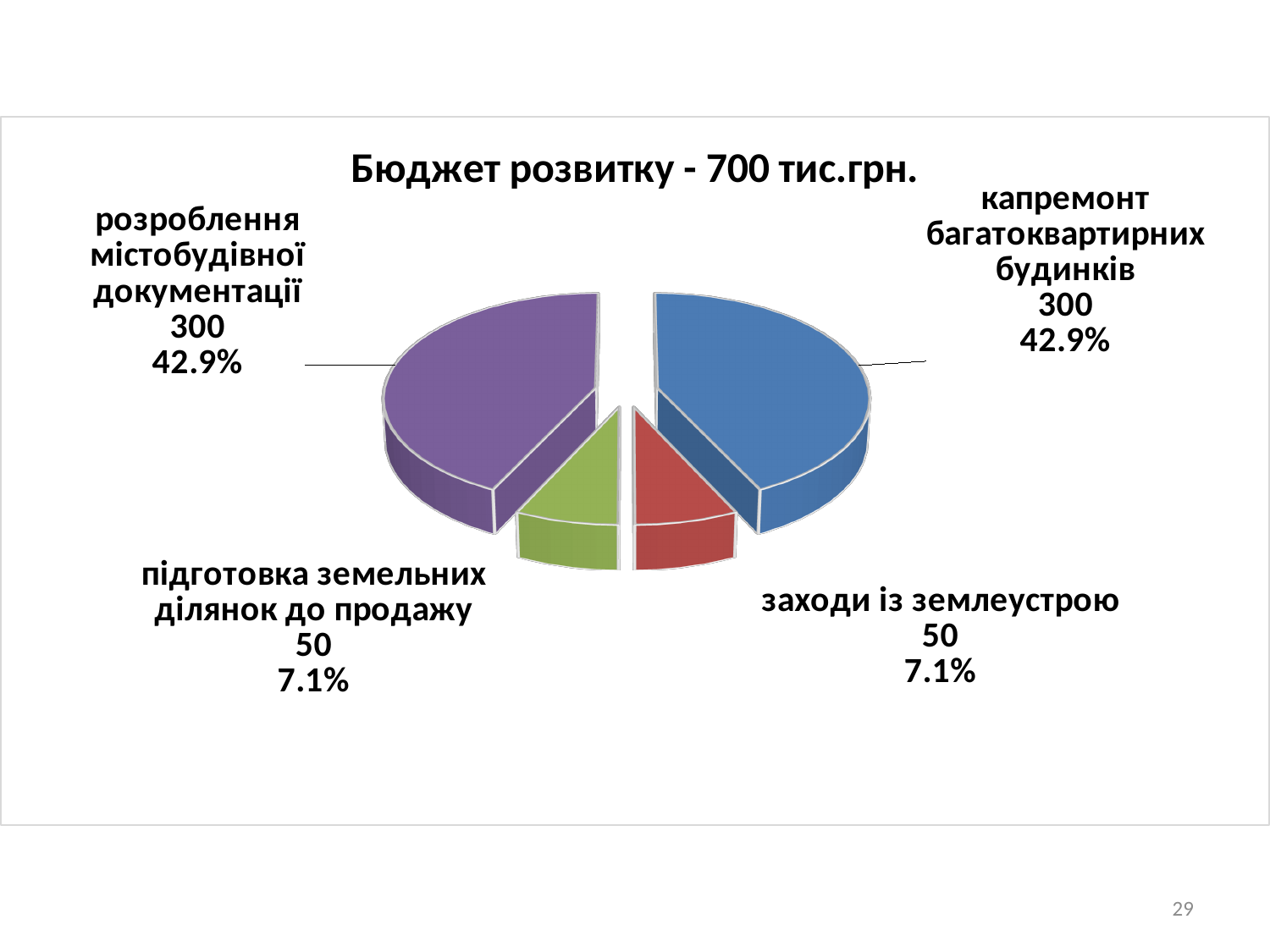
How many slices does the pie chart have? 4 What is the value for підготовка земельних ділянок до продажу? 50 What is the value for заходи із землеустрою? 50 What is the difference between the values for розроблення містобудівної документації and заходи із землеустрою? 250 What kind of chart is shown on the slide? pie chart What is the title of the chart? Бюджет розвитку - 700 тис.грн. What is the value for капремонт багатоквартирних будинків? 300 What share of the pie does розроблення містобудівної документації represent? 42.9% What colour is the slice for капремонт багатоквартирних будинків? blue Which is larger, капремонт багатоквартирних будинків or підготовка земельних ділянок до продажу? капремонт багатоквартирних будинків What share of the pie does заходи із землеустрою represent? 7.1% What is the value for розроблення містобудівної документації? 300